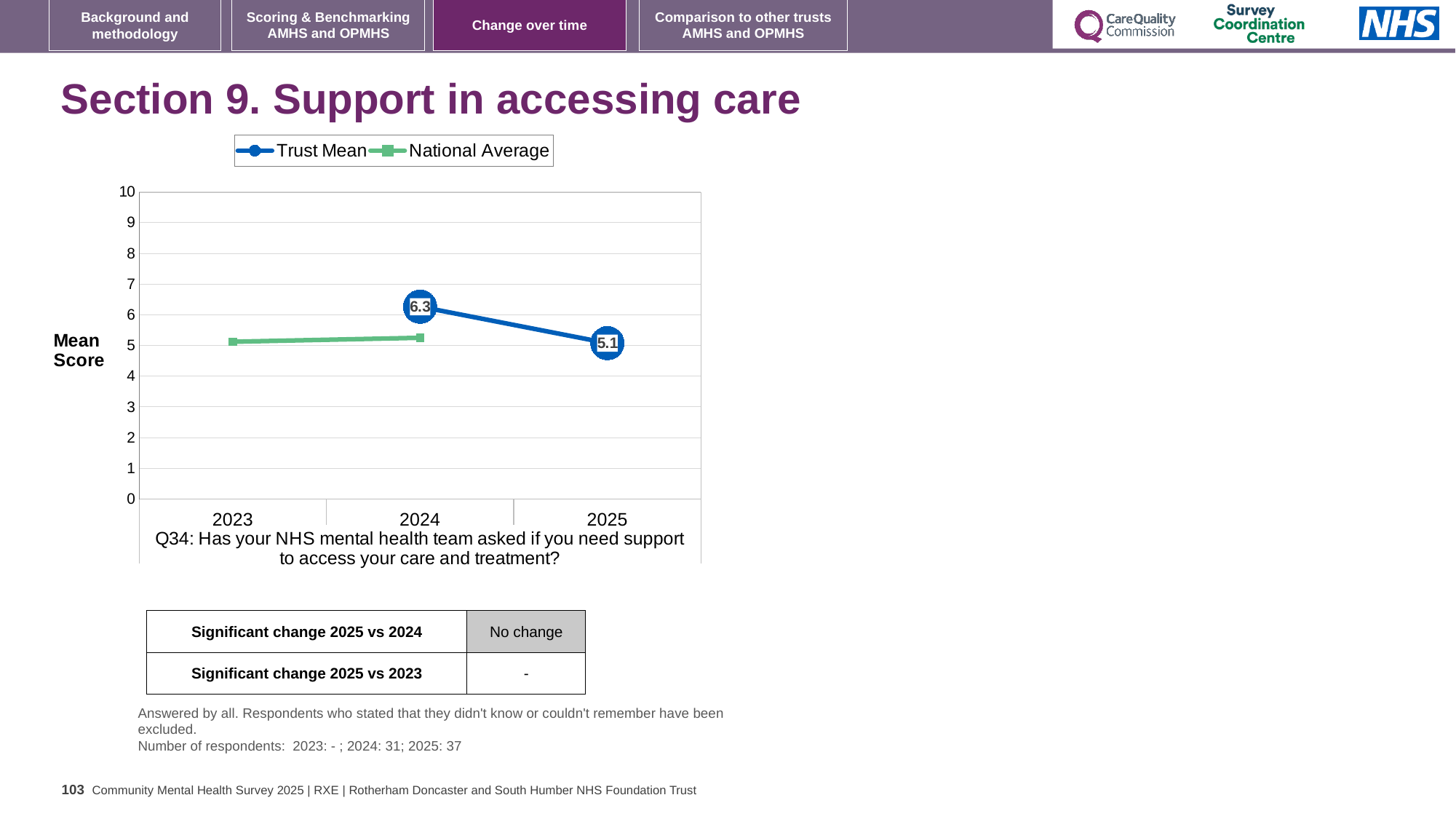
What is the Trust Mean score for 2024? 6.3 How many series does the legend list? 2 How many years are shown on the x axis? 3 Does the Trust Mean score rise or fall from 2024 to 2025? fall Is the National Average value for 2023 greater or less than 6? less Is the National Average value for 2024 greater or less than 7? less Which year has the higher Trust Mean score, 2024 or 2025? 2024 What is the Trust Mean score for 2025? 5.1 By how much did the Trust Mean score change between 2024 and 2025? 1.2 What is the label on the y axis of the chart? Mean Score In which year is the Trust Mean score highest? 2024 What kind of chart is shown on the slide? line chart